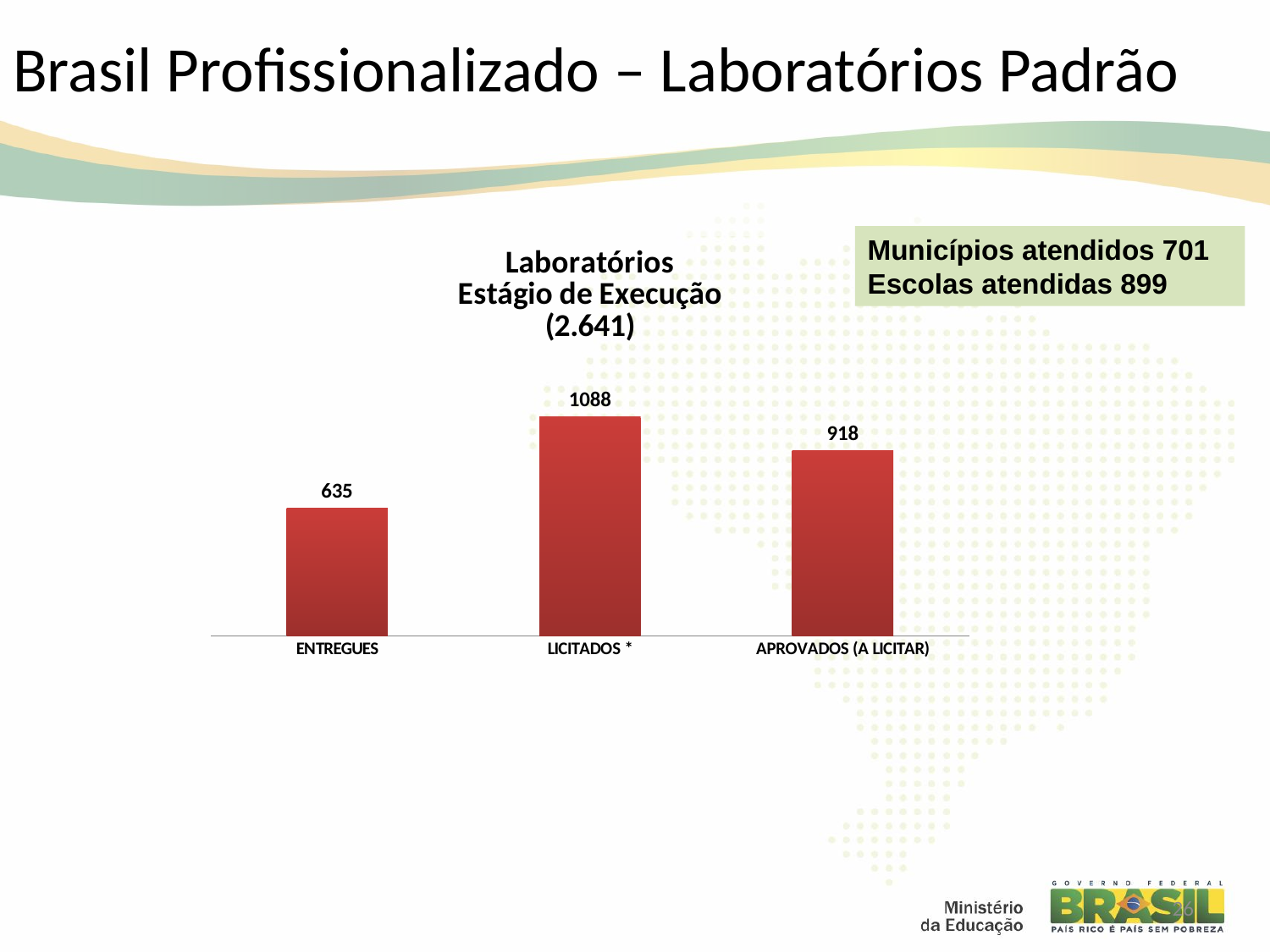
What kind of chart is shown on the slide? bar chart What is the value for APROVADOS (A LICITAR)? 918 What is the total of the three values shown in the chart? 2641 What is the title of the chart? Laboratórios Estágio de Execução (2.641) What is the difference between the values for LICITADOS * and ENTREGUES? 453 How many categories are shown in the chart? 3 Which is larger, the value for APROVADOS (A LICITAR) or the value for ENTREGUES? APROVADOS (A LICITAR) Which category has the lowest value? ENTREGUES Which category has the highest value? LICITADOS * What is the value for LICITADOS *? 1088 What is the difference between the values for LICITADOS * and APROVADOS (A LICITAR)? 170 What is the value for ENTREGUES? 635